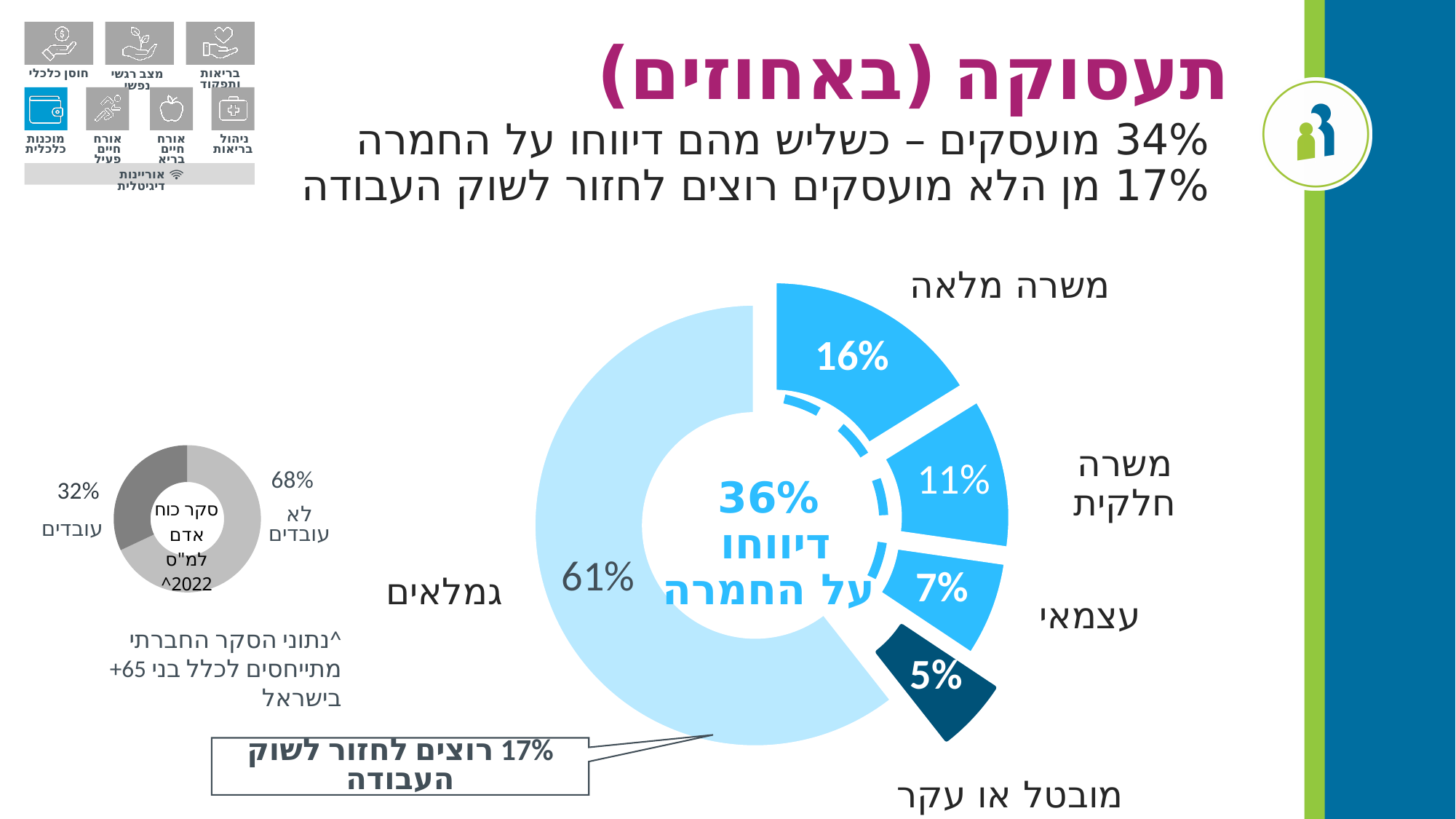
In the large donut chart, which category has the smallest share? מובטל או עקר In the large donut chart, which is larger: עצמאי or משרה חלקית? משרה חלקית In the large donut chart, what is the value for משרה מלאה (full-time)? 16% In the large donut chart, what is the value for גמלאים (retirees)? 61% In the small donut chart on the left (סקר כוח אדם למ"ס 2022), what is the value for עובדים (working)? 32% In the small donut chart on the left, what is the value for לא עובדים (not working)? 68% How many categories does the large donut chart show? 5 In the large donut chart, what is the difference between משרה מלאה and משרה חלקית? 5% What percentage is printed in the centre of the large donut chart? 36% In the large donut chart, what is the value for מובטל או עקר (unemployed or homemaker)? 5% In the large donut chart, which category has the largest share? גמלאים What type of chart is the large chart in the centre of the slide? Donut (pie) chart